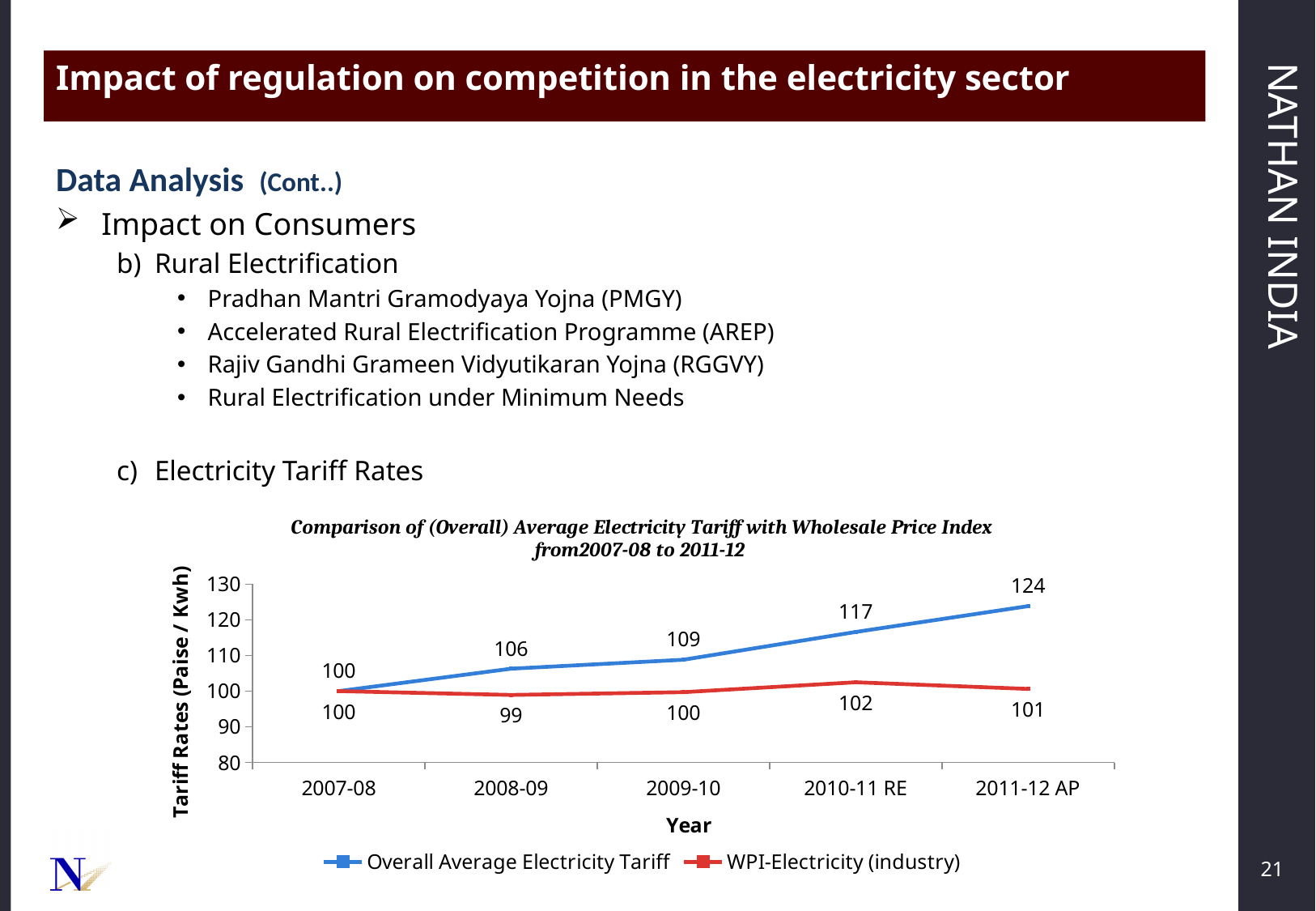
What is the value of Overall Average Electricity Tariff in 2011-12 AP? 124 In which year is the Overall Average Electricity Tariff highest? 2011-12 AP What is the value of WPI-Electricity (industry) in 2008-09? 99 In which year is WPI-Electricity (industry) lowest? 2008-09 What is the label of the y axis of the chart? Tariff Rates (Paise / Kwh) How many years are shown on the x axis of the chart? 5 What is the difference between Overall Average Electricity Tariff and WPI-Electricity (industry) in 2010-11 RE? 15 What kind of chart is shown on the slide? Line chart What is the value of Overall Average Electricity Tariff in 2009-10? 109 Does the Overall Average Electricity Tariff rise or fall from 2007-08 to 2011-12 AP? Rise How many series does the chart legend list? 2 Which series has the larger value in 2011-12 AP, Overall Average Electricity Tariff or WPI-Electricity (industry)? Overall Average Electricity Tariff